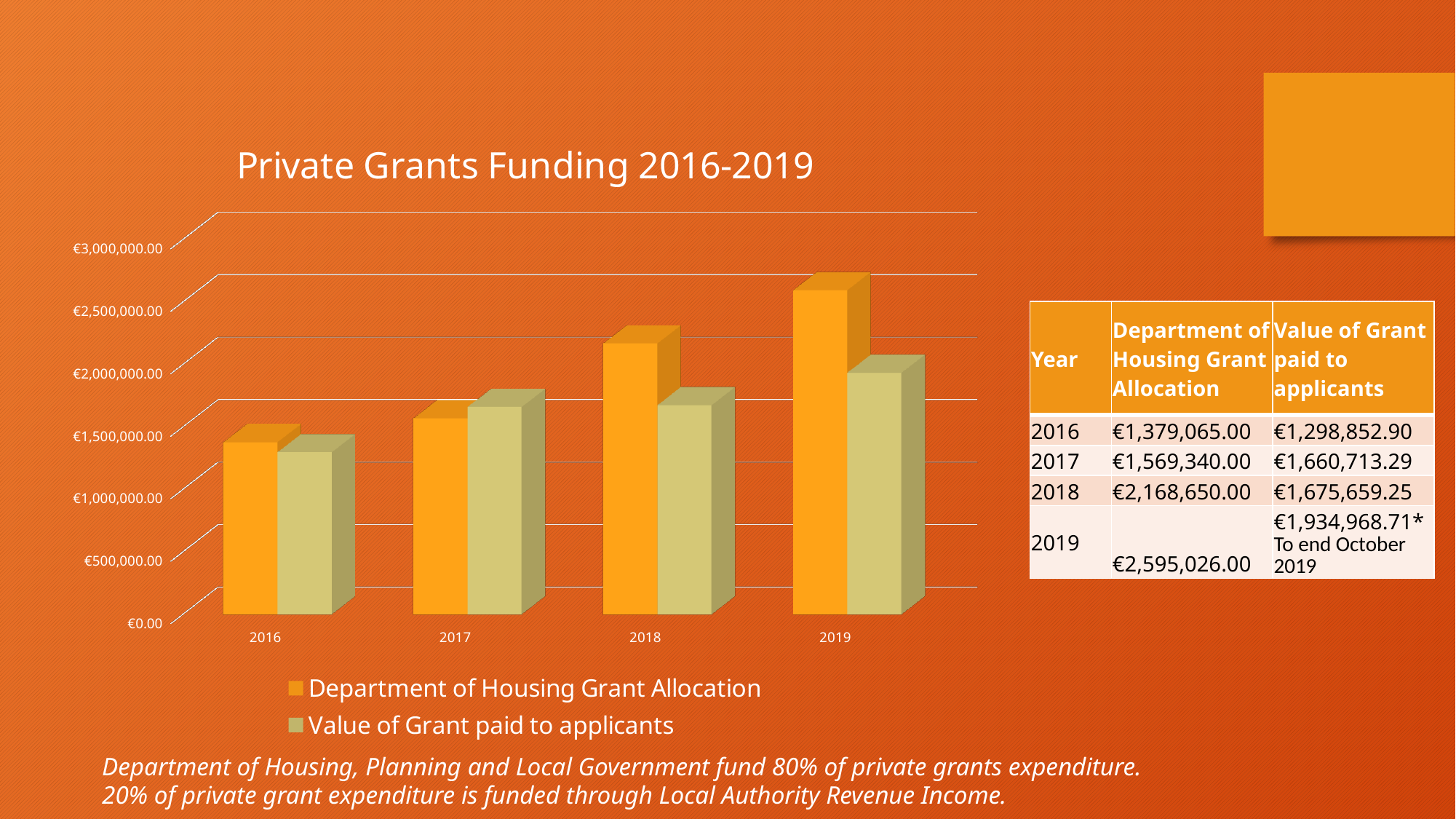
What is the title of the chart? Private Grants Funding 2016-2019 Which year had the highest Department of Housing Grant Allocation? 2019 What kind of chart is shown on the slide? bar chart In 2017, which was larger: the Department of Housing Grant Allocation or the Value of Grant paid to applicants? Value of Grant paid to applicants How many series does the chart legend list? 2 Which year had the lowest Value of Grant paid to applicants? 2016 How many years are plotted on the x axis of the chart? 4 Does the Department of Housing Grant Allocation rise or fall from 2016 to 2019? rise What is the difference between the Department of Housing Grant Allocation and the Value of Grant paid to applicants in 2018? €492,990.75 What was the Value of Grant paid to applicants in 2016? €1,298,852.90 Is the Department of Housing Grant Allocation for 2019 greater or less than €2,500,000.00? greater What was the Department of Housing Grant Allocation in 2018? €2,168,650.00